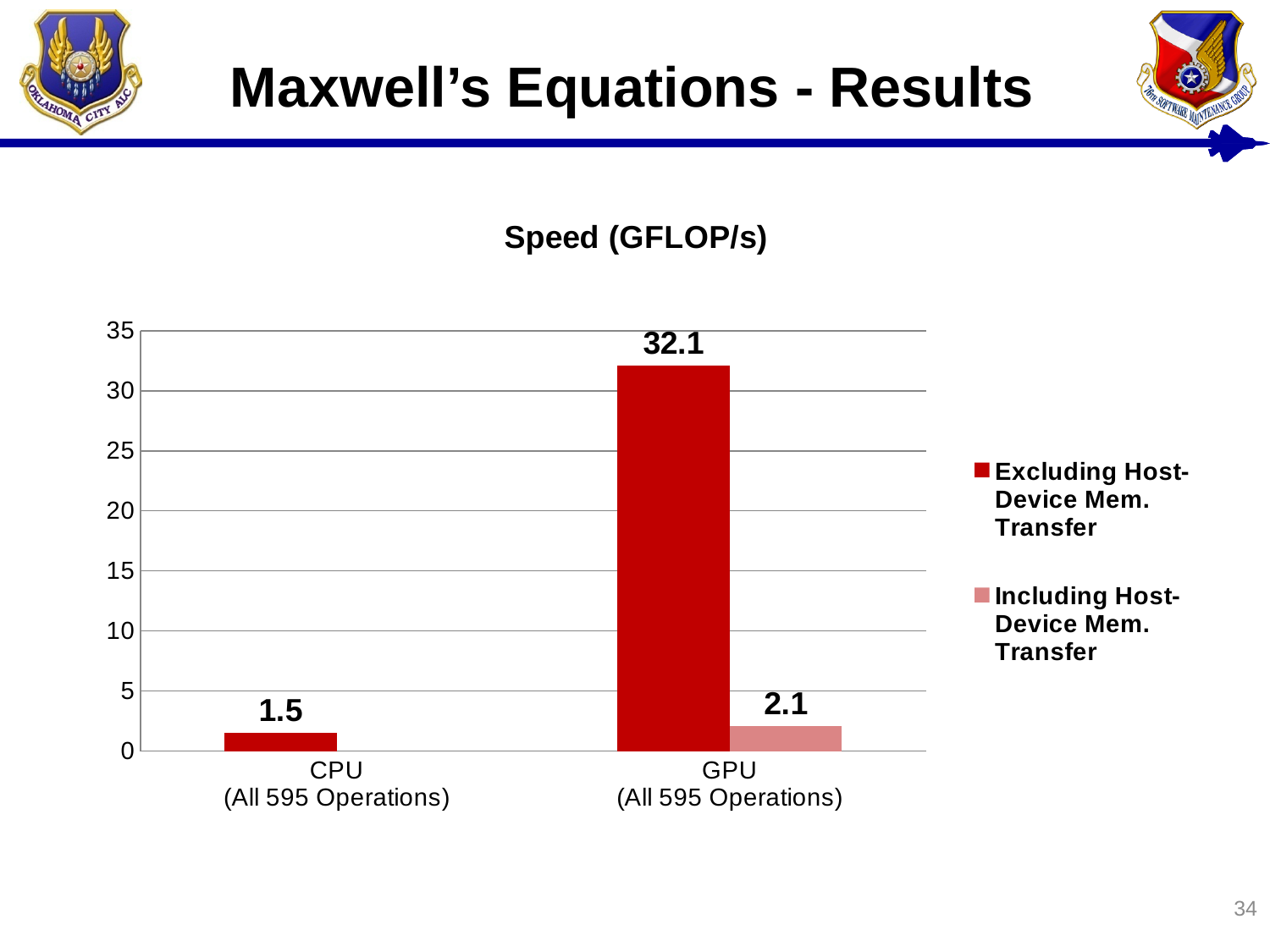
What is the difference between the GPU Excluding Host-Device Mem. Transfer value and the GPU Including Host-Device Mem. Transfer value? 30 How many categories are shown on the x axis? 2 Is the GPU Excluding Host-Device Mem. Transfer value greater or less than 30? greater What is the chart's title? Speed (GFLOP/s) Which is larger: the CPU Excluding Host-Device Mem. Transfer value or the GPU Including Host-Device Mem. Transfer value? GPU Including Host-Device Mem. Transfer What is the value for CPU (All 595 Operations) in the Excluding Host-Device Mem. Transfer series? 1.5 What type of chart is shown on the slide? bar chart How many series does the legend list? 2 Which category has the highest value in the Excluding Host-Device Mem. Transfer series? GPU (All 595 Operations) What is the value for GPU (All 595 Operations) in the Excluding Host-Device Mem. Transfer series? 32.1 What is the difference between the GPU and CPU values in the Excluding Host-Device Mem. Transfer series? 30.6 What is the value for GPU (All 595 Operations) in the Including Host-Device Mem. Transfer series? 2.1